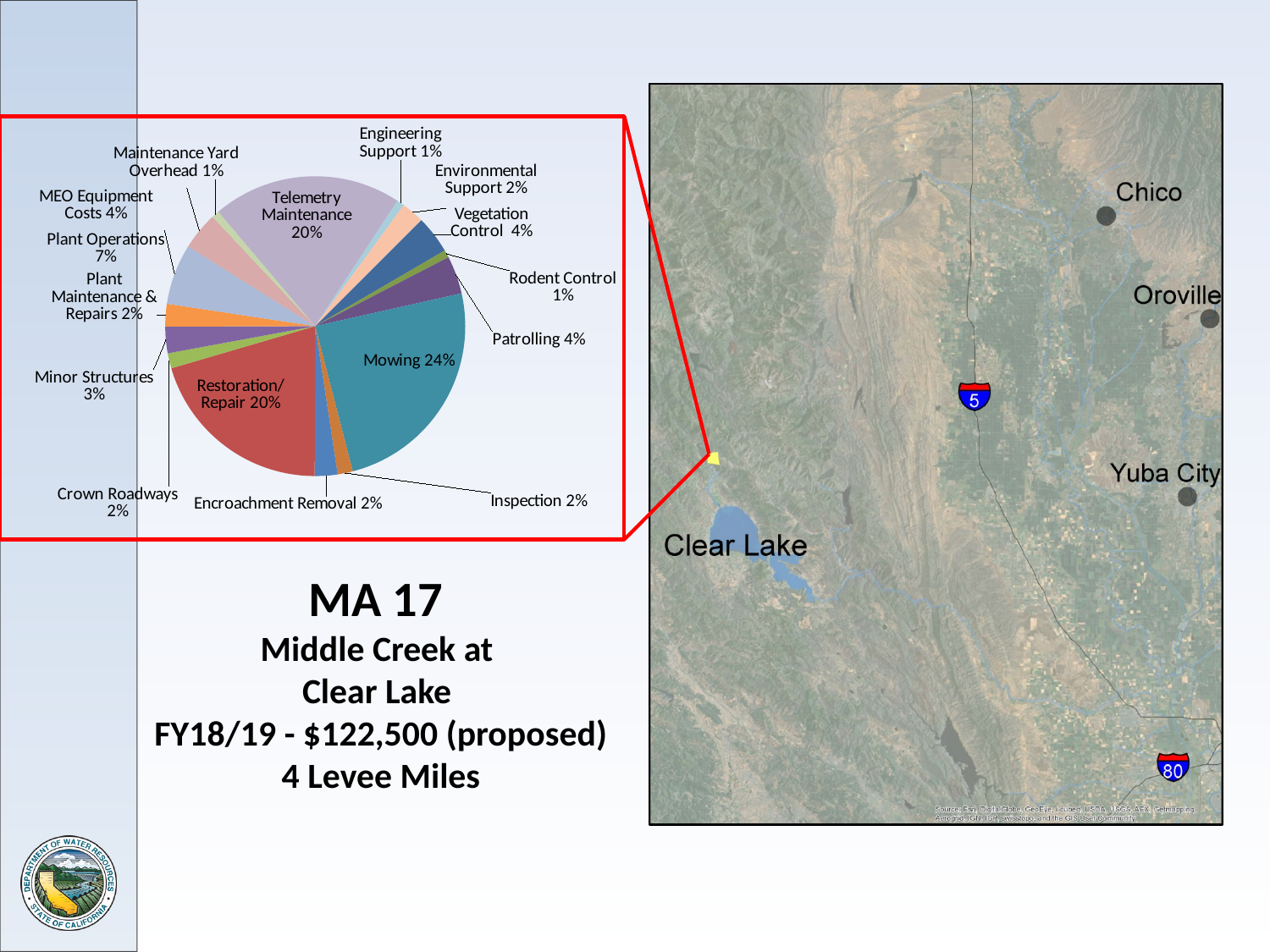
What is the value for Telemetry Maintenance? 20% What is the value for Vegetation Control? 4% What is the value for Rodent Control? 1% What is the value for Minor Structures? 3% What is the value for Restoration/Repair? 20% What share of the pie does Mowing represent? 24% What is the difference between the Mowing share and the Restoration/Repair share? 4% What is the value for Plant Operations? 7% Which is larger, Plant Operations or MEO Equipment Costs? Plant Operations What kind of chart is shown on the slide? pie chart How many categories are shown in the pie chart? 16 Which category has the largest share of the pie? Mowing